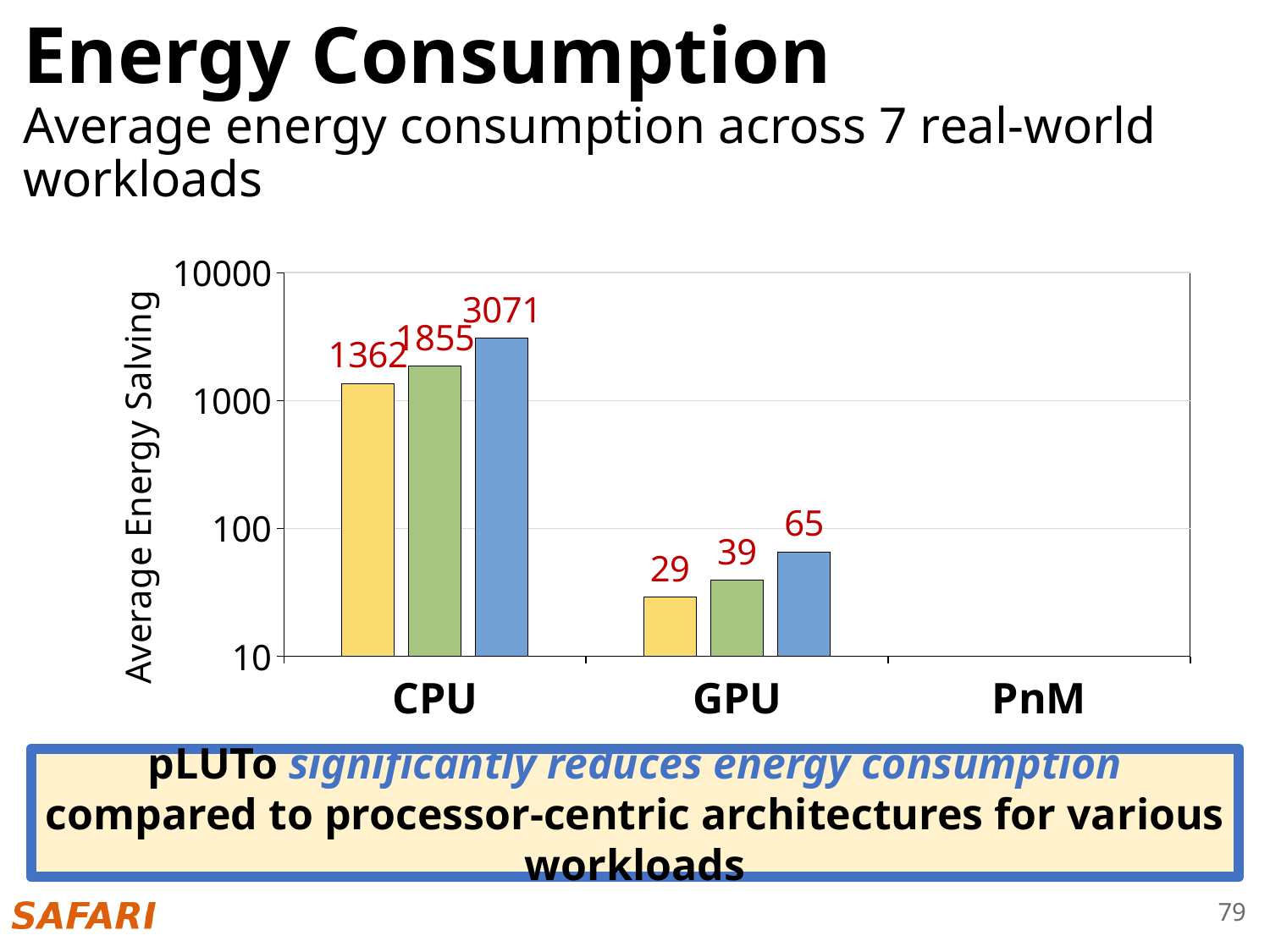
Is the value of the yellow bar for GPU greater or less than 100? less Which is larger, the green bar for CPU or the blue bar for GPU? the green bar for CPU What is the difference between the blue bar and the yellow bar for CPU? 1709 What is the value of the yellow bar for CPU? 1362 What is the value of the blue bar for GPU? 65 What is the value of the green bar for GPU? 39 Which category has the highest labelled bar value? CPU What is the difference between the blue bar and the yellow bar for GPU? 36 What is the label of the y axis? Average Energy Salving What is the value of the green bar for CPU? 1855 What kind of chart is shown on the slide? bar chart How many categories are labelled on the x axis? 3